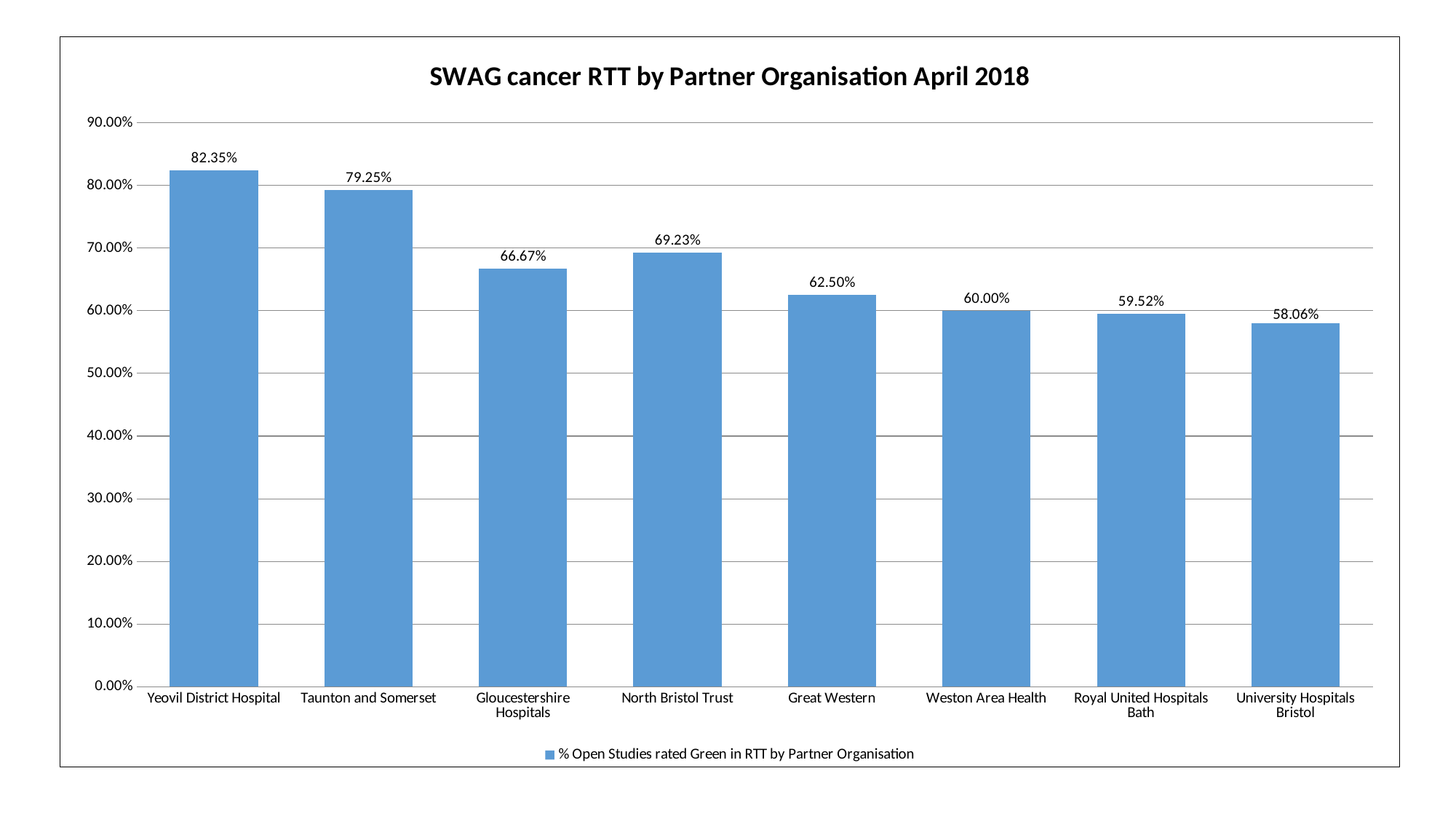
What is the difference between the values for Yeovil District Hospital and Taunton and Somerset? 3.10% What is the value for North Bristol Trust? 69.23% What is the value for Royal United Hospitals Bath? 59.52% Which partner organisation has the highest value? Yeovil District Hospital How many partner organisations are shown on the chart? 8 Which is larger, the value for Gloucestershire Hospitals or the value for North Bristol Trust? North Bristol Trust What is the title of the chart? SWAG cancer RTT by Partner Organisation April 2018 Is the value for Great Western greater or less than 60.00%? greater What kind of chart is shown on the slide? Bar chart Which partner organisation has the lowest value? University Hospitals Bristol What is the value for Yeovil District Hospital? 82.35% How many series does the legend list? 1